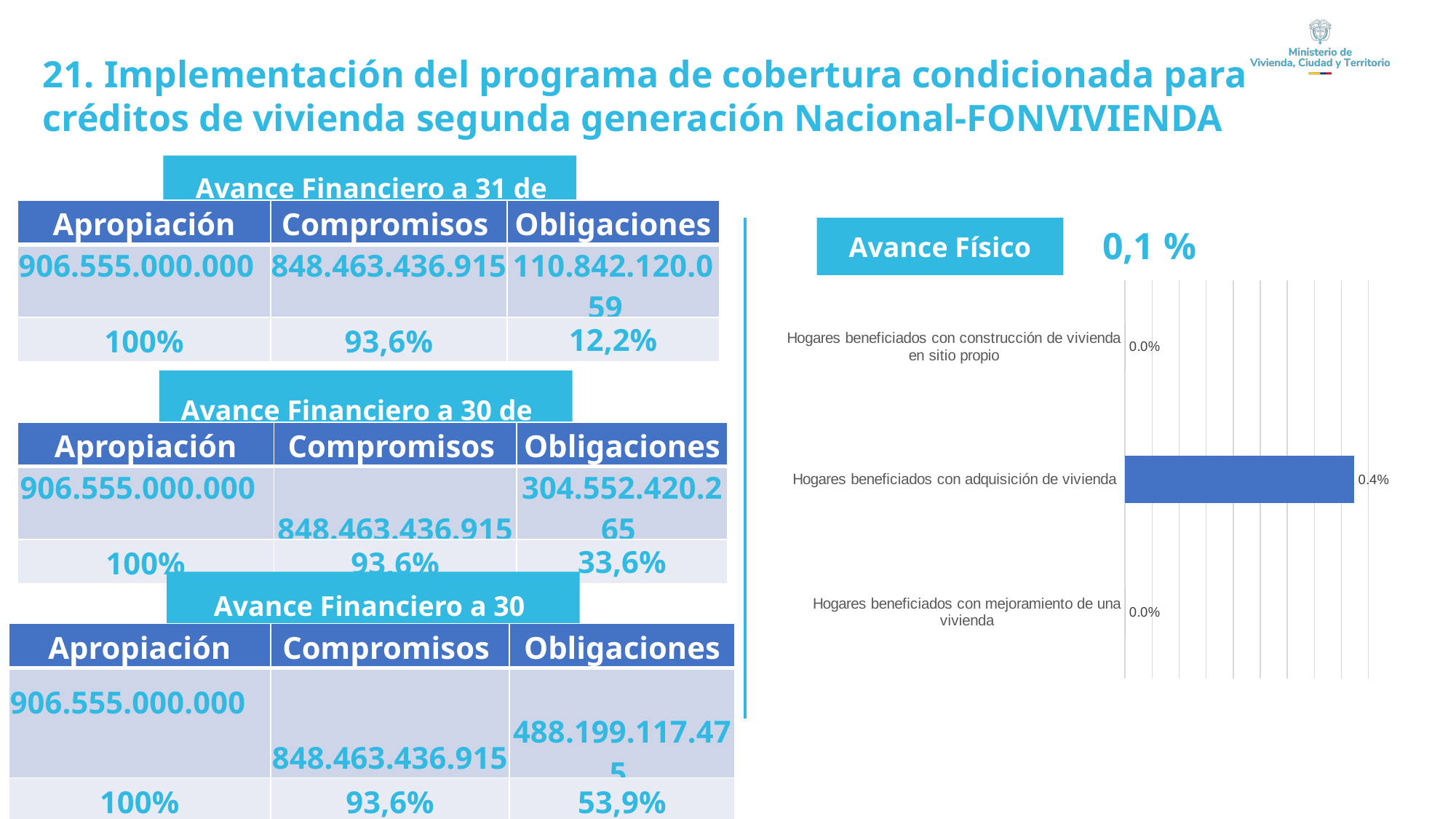
What is the value for "Hogares beneficiados con adquisición de vivienda" in the bar chart? 0.4% Which category has the highest value in the bar chart? Hogares beneficiados con adquisición de vivienda What is the difference between the value for "Hogares beneficiados con adquisición de vivienda" and the value for "Hogares beneficiados con construcción de vivienda en sitio propio" in the bar chart? 0.4% What is the value for "Hogares beneficiados con construcción de vivienda en sitio propio" in the bar chart? 0.0% In the bar chart, which is larger: the value for "Hogares beneficiados con adquisición de vivienda" or the value for "Hogares beneficiados con mejoramiento de una vivienda"? Hogares beneficiados con adquisición de vivienda What is the heading shown above the bar chart on the right side of the slide? Avance Físico What is the value for "Hogares beneficiados con mejoramiento de una vivienda" in the bar chart? 0.0% How many categories in the bar chart have a value of 0.0%? 2 How many categories does the bar chart show? 3 What percentage is printed next to the "Avance Físico" heading above the bar chart? 0,1 % What kind of chart is shown on the right side of the slide? bar chart